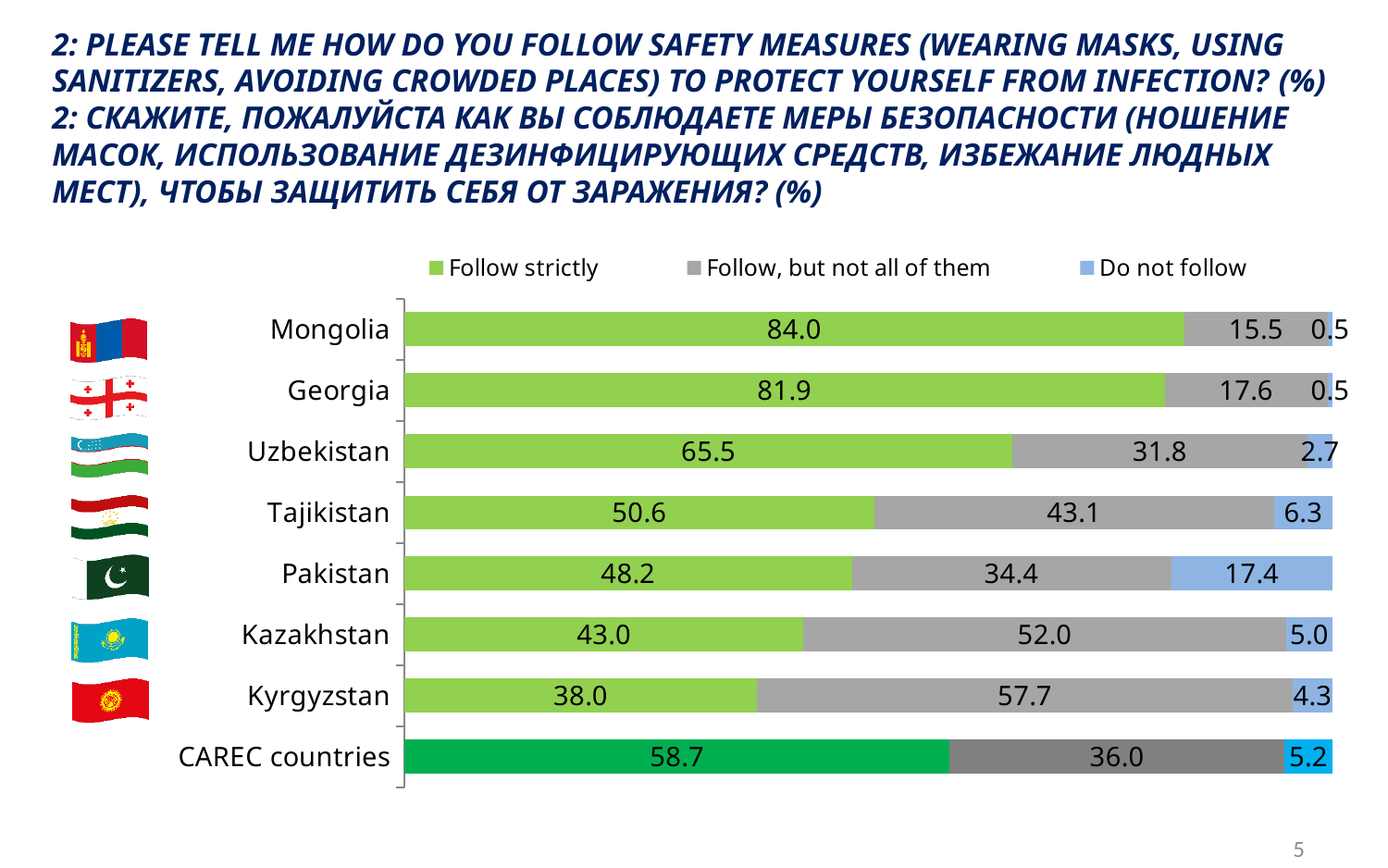
Which country has the lowest 'Follow strictly' value? Kyrgyzstan Which country has the highest 'Follow strictly' value? Mongolia What kind of chart is shown on the slide? Stacked bar chart Which series is shown in green in the legend? Follow strictly How many series does the legend list? 3 Which has a larger 'Do not follow' value, Tajikistan or Kazakhstan? Tajikistan What percentage of respondents in Mongolia follow safety measures strictly? 84.0 What is the difference between the 'Follow strictly' values for Uzbekistan and Tajikistan? 14.9 What is the 'Follow, but not all of them' value for Kyrgyzstan? 57.7 How many categories (countries/groups) are shown on the chart? 8 What is the 'Do not follow' value for Pakistan? 17.4 What is the total of the three values for the CAREC countries bar? 99.9